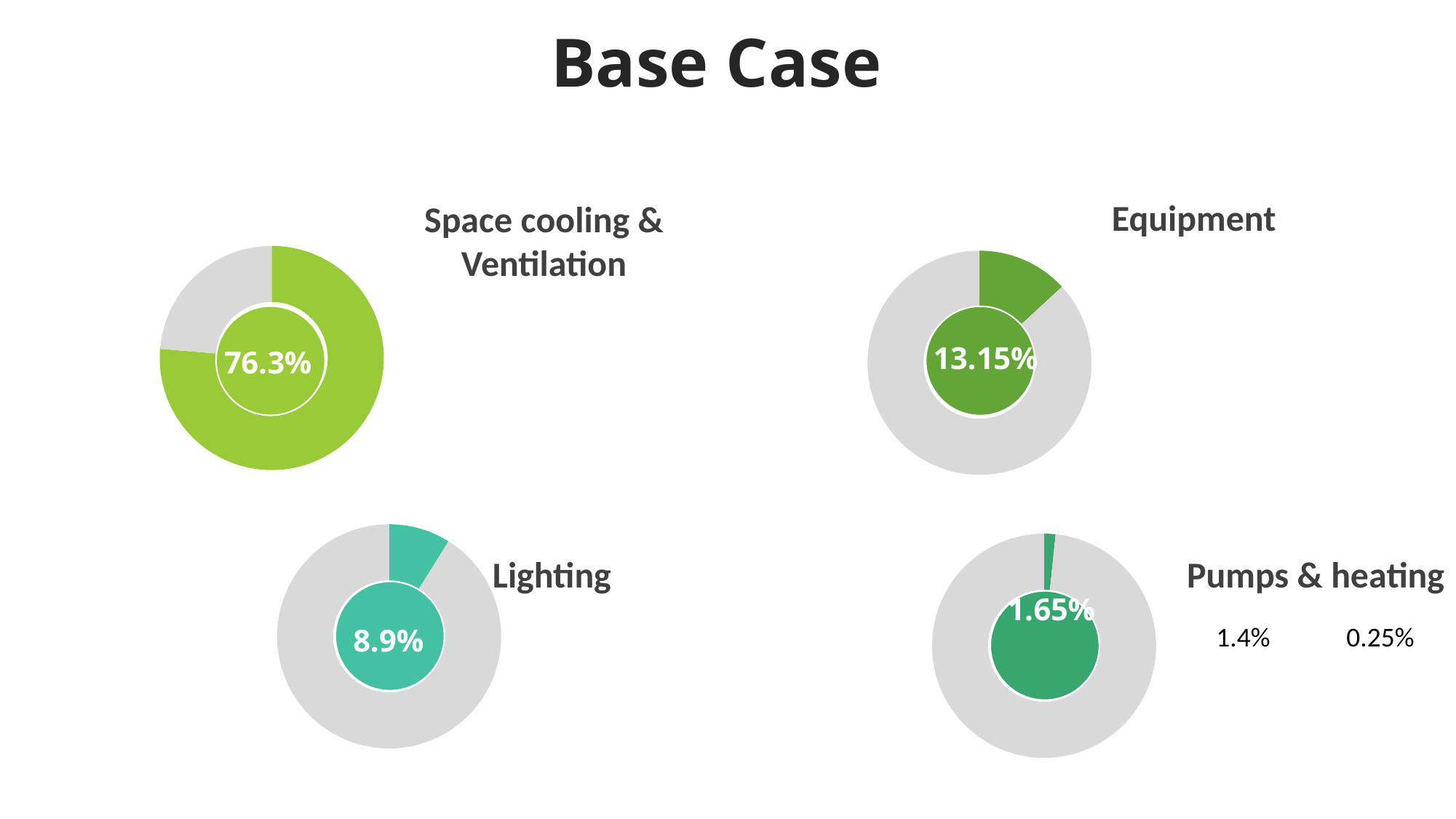
What percentage is shown in the Equipment chart? 13.15% What is the title of the slide? Base Case Which is larger, the Lighting percentage or the Pumps & heating percentage? Lighting Which of the four charts shows the lowest percentage? Pumps & heating How many donut charts are shown on the slide? 4 What kind of chart is used for Space cooling & Ventilation? Donut (pie) chart What percentage is shown in the Space cooling & Ventilation chart? 76.3% What is the difference between the Space cooling & Ventilation percentage and the Equipment percentage? 63.15% What is the difference between the Equipment percentage and the Lighting percentage? 4.25% What percentage is shown in the Lighting chart? 8.9% What percentage is shown in the Pumps & heating chart? 1.65% Which of the four charts shows the highest percentage? Space cooling & Ventilation